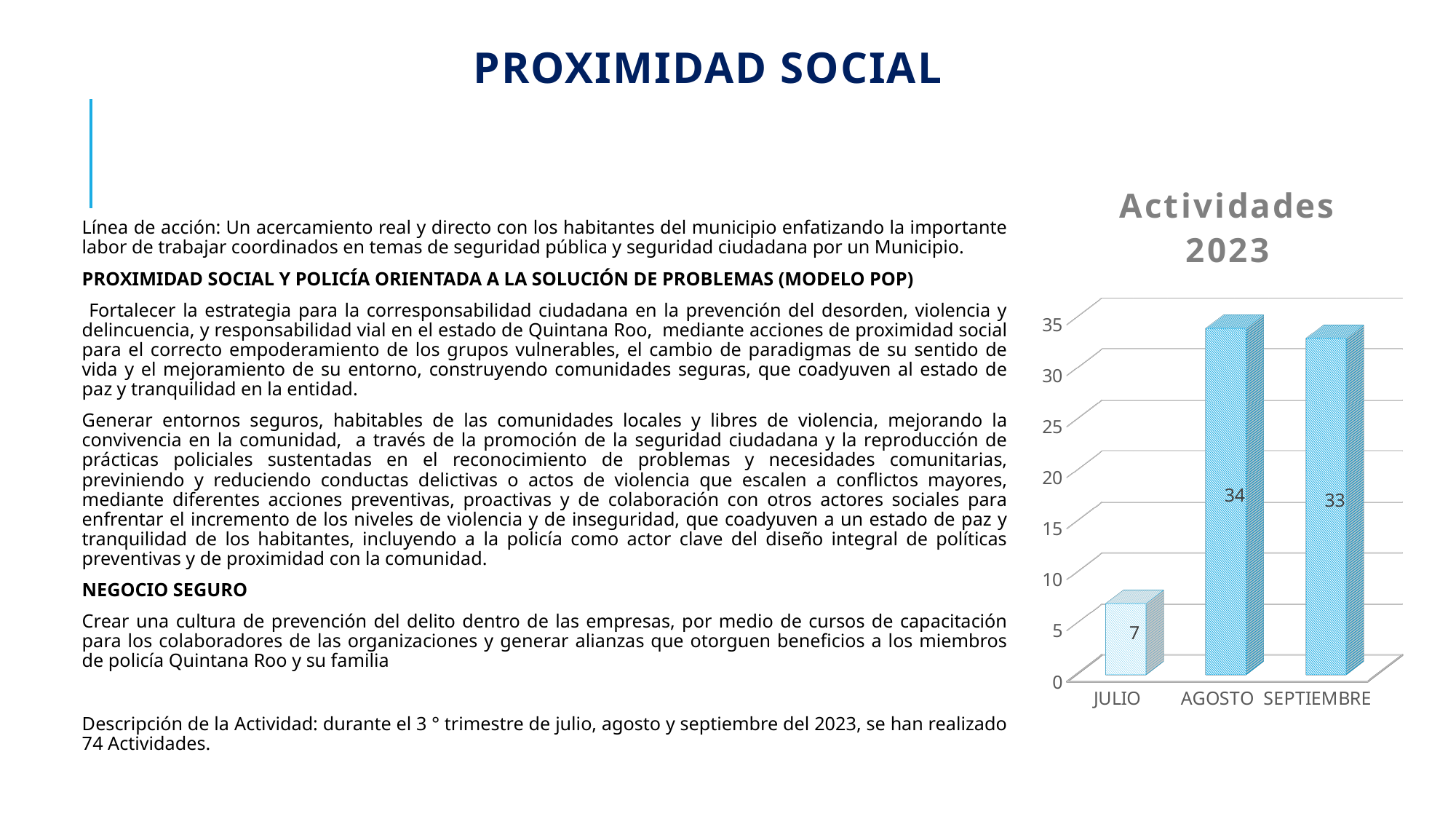
How many months are shown in the Actividades 2023 chart? 3 Is the value for JULIO in the Actividades 2023 chart greater or less than 10? less Which month has the lowest value in the Actividades 2023 chart? JULIO Which is larger in the Actividades 2023 chart, the value for JULIO or the value for SEPTIEMBRE? SEPTIEMBRE What kind of chart is the Actividades 2023 chart? bar chart What is the value for JULIO in the Actividades 2023 chart? 7 What is the value for SEPTIEMBRE in the Actividades 2023 chart? 33 What is the value for AGOSTO in the Actividades 2023 chart? 34 What is the difference between the values for AGOSTO and SEPTIEMBRE in the Actividades 2023 chart? 1 Which month has the highest value in the Actividades 2023 chart? AGOSTO What is the title of the chart on the slide? Actividades 2023 What is the difference between the values for AGOSTO and JULIO in the Actividades 2023 chart? 27